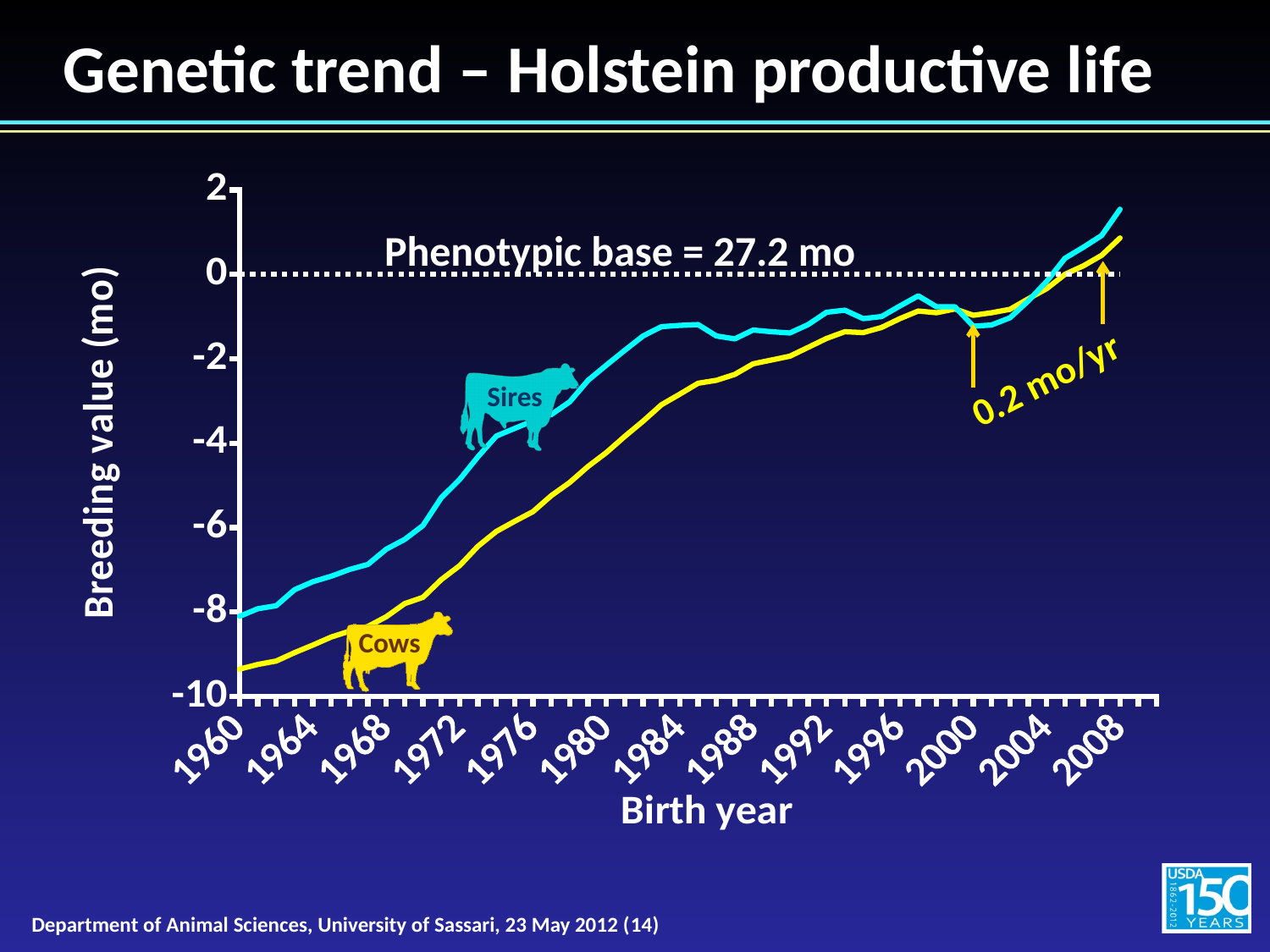
Is the breeding value for Cows in 1984 greater or less than -2? less Do the breeding values for Sires rise or fall from 1960 to 2008? rise How many series are plotted on the chart? 2 Which two series are plotted on the chart? Sires and Cows Is the breeding value for Sires in 1984 greater or less than -2? greater Is the breeding value for Sires in 2008 greater or less than 0? greater In 1976, which series has the higher breeding value, Sires or Cows? Sires Do the breeding values for Cows rise or fall across the birth years shown? rise What kind of chart is shown on the slide? line chart What phenotypic base value is stated on the chart's dotted zero line? 27.2 mo